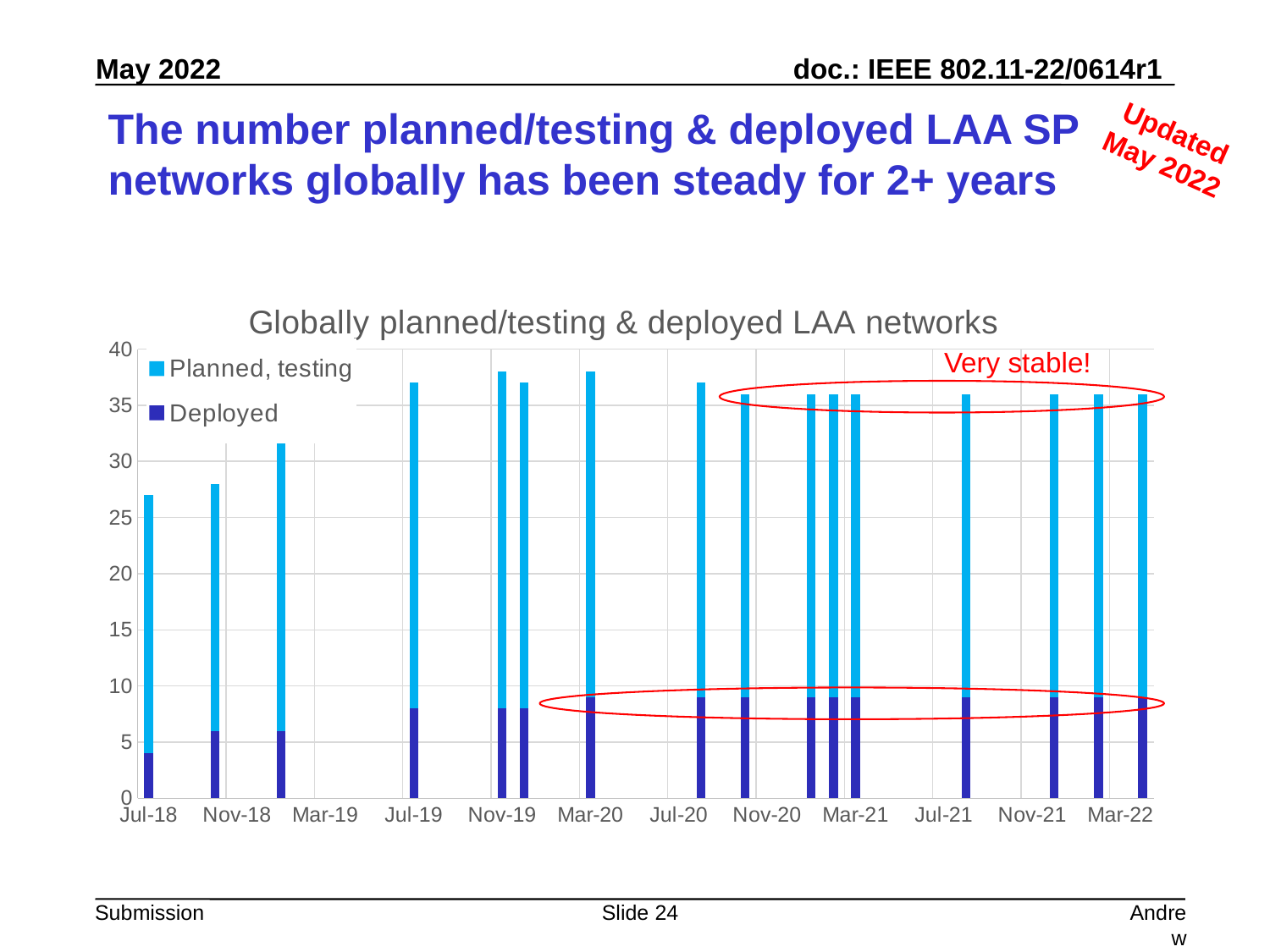
What is the title of the chart? Globally planned/testing & deployed LAA networks Which has the larger Deployed value, Jul-18 or Mar-20? Mar-20 What kind of chart is shown on the slide? Stacked bar chart Is the total height of the Jul-19 bar greater or less than 35? greater How many series does the legend list? 2 Is the Deployed value for Nov-18 greater or less than 5? greater Is the Deployed value for Jul-18 greater or less than 5? less Which series is drawn in dark blue? Deployed Which bar has the larger total, Jul-18 or Jul-19? Jul-19 Do the total bar heights rise or fall from Jul-18 to Jul-19? rise